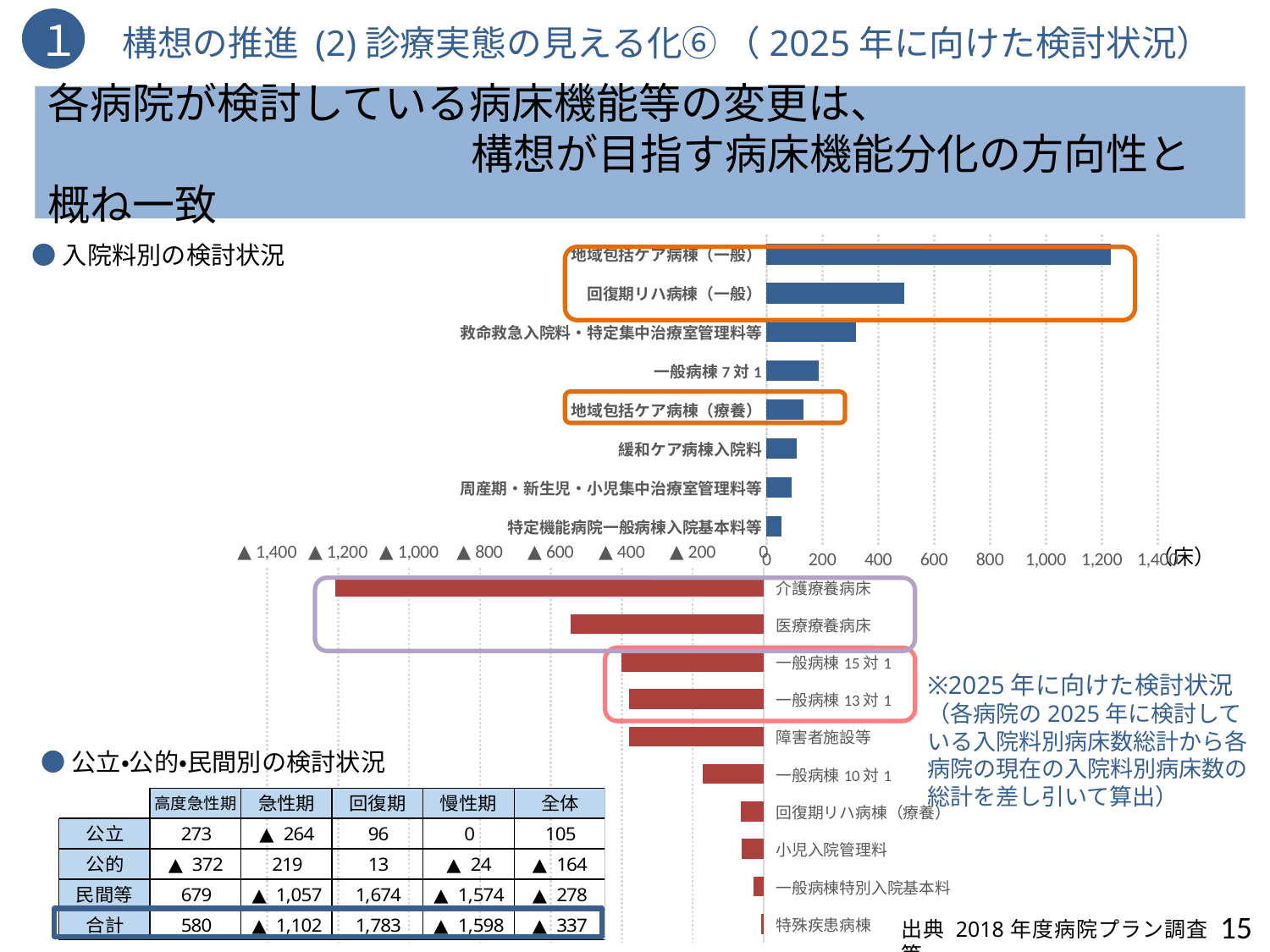
Is the decrease shown for 介護療養病床 greater or less than 1,400 beds? less Which category shows the largest decrease (longest bar to the left of 0)? 介護療養病床 What unit is shown at the end of the horizontal axis of the chart? 床 Is the decrease shown for 医療療養病床 greater or less than 600 beds? less Which has the larger value, 回復期リハ病棟（一般） or 救命救急入院料・特定集中治療室管理料等? 回復期リハ病棟（一般） What kind of chart is shown on the slide? bar chart Which shows the larger decrease, 介護療養病床 or 医療療養病床? 介護療養病床 Is the value for 地域包括ケア病棟（一般） greater or less than 1,000? greater How many categories are plotted in the bar chart? 18 Which category shows the largest increase (longest bar to the right of 0)? 地域包括ケア病棟（一般）